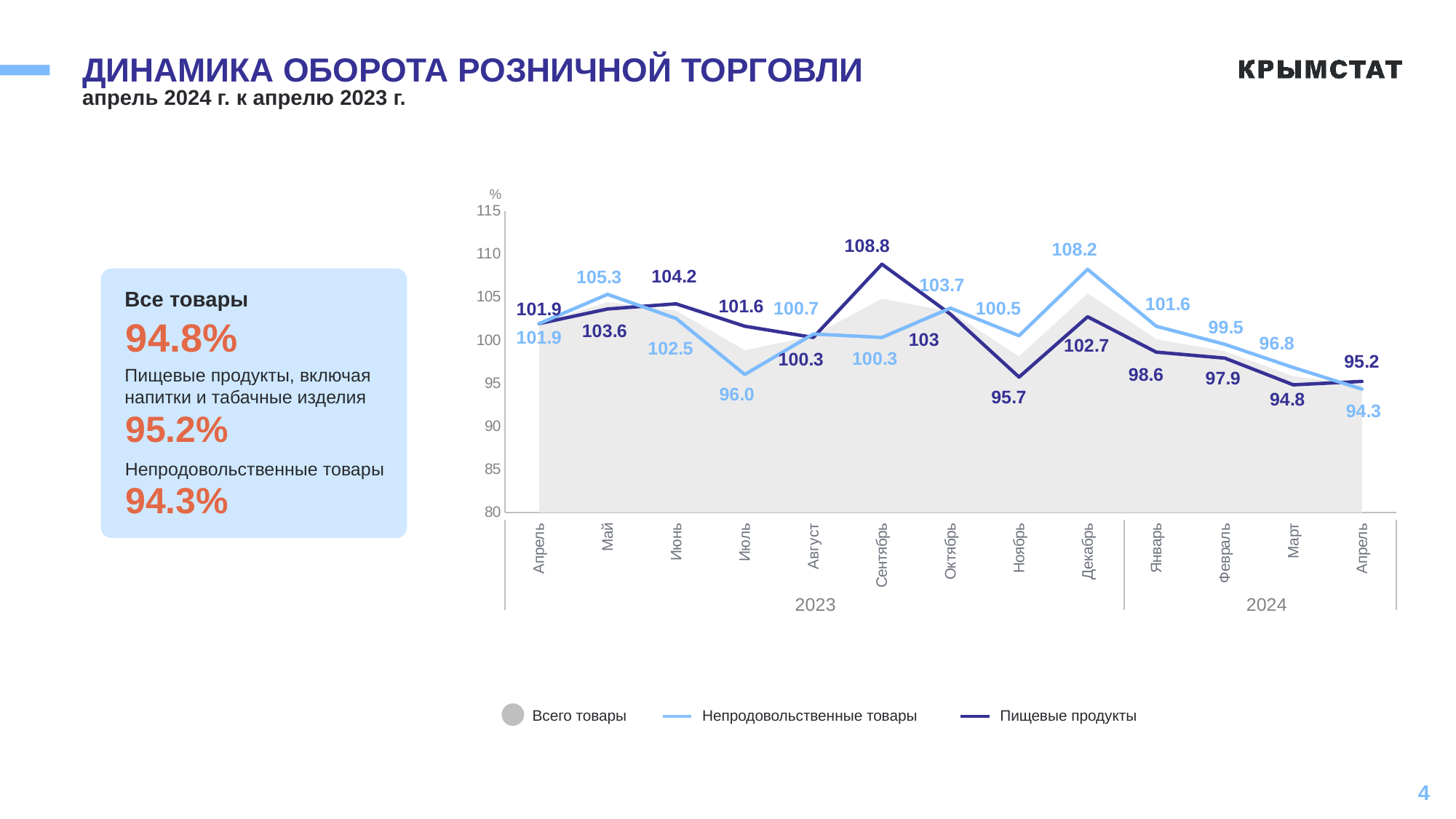
What type of chart is shown? combination area and line chart In which month is the Непродовольственные товары line at its highest? Декабрь 2023 What is the value for Пищевые продукты in Сентябрь 2023? 108.8 What is the difference between Пищевые продукты and Непродовольственные товары in Сентябрь 2023? 8.5 How many series does the legend list? 3 What is the value for Пищевые продукты in Апрель 2024? 95.2 What is the value for Непродовольственные товары in Декабрь 2023? 108.2 In which month is the Пищевые продукты line at its lowest? Март 2024 Which is larger in Ноябрь 2023: Непродовольственные товары or Пищевые продукты? Непродовольственные товары Is the value for Всего товары in Сентябрь 2023 greater or less than 100? greater What is the value for Непродовольственные товары in Июль 2023? 96.0 How many months are plotted on the x axis? 13